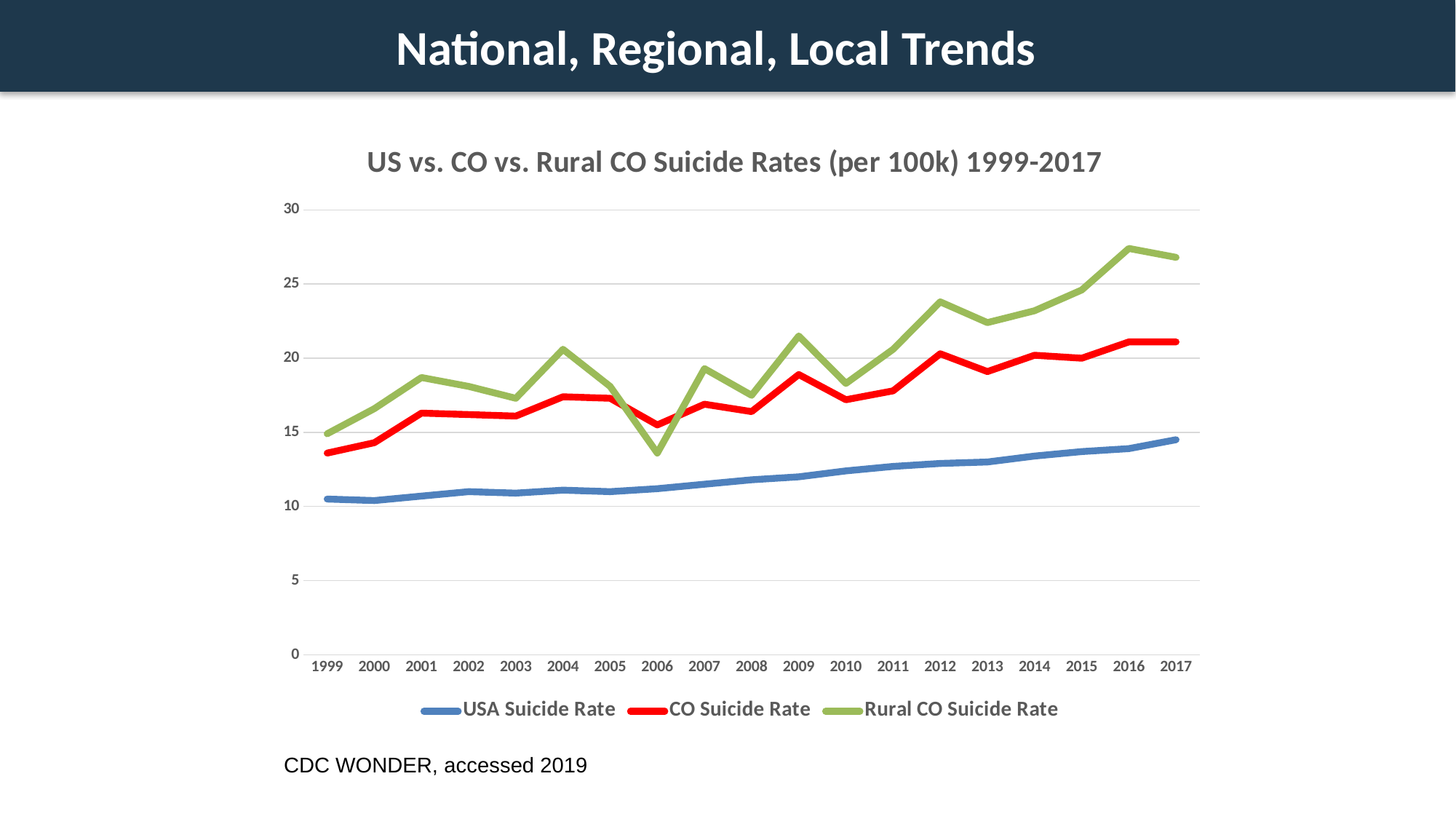
How many series does the legend list? 3 Is the CO Suicide Rate in 2017 greater or less than 20? greater Does the USA Suicide Rate rise or fall from 1999 to 2017? rise Is the USA Suicide Rate in 1999 greater or less than 15? less Is the Rural CO Suicide Rate in 2016 greater or less than 25? greater What is the title of the chart? US vs. CO vs. Rural CO Suicide Rates (per 100k) 1999-2017 In which year is the Rural CO Suicide Rate at its lowest? 2006 Which series has the highest value in 2017? Rural CO Suicide Rate In 2006, which is higher, the CO Suicide Rate or the Rural CO Suicide Rate? CO Suicide Rate How many years are plotted along the x axis? 19 What kind of chart is shown on the slide? line chart